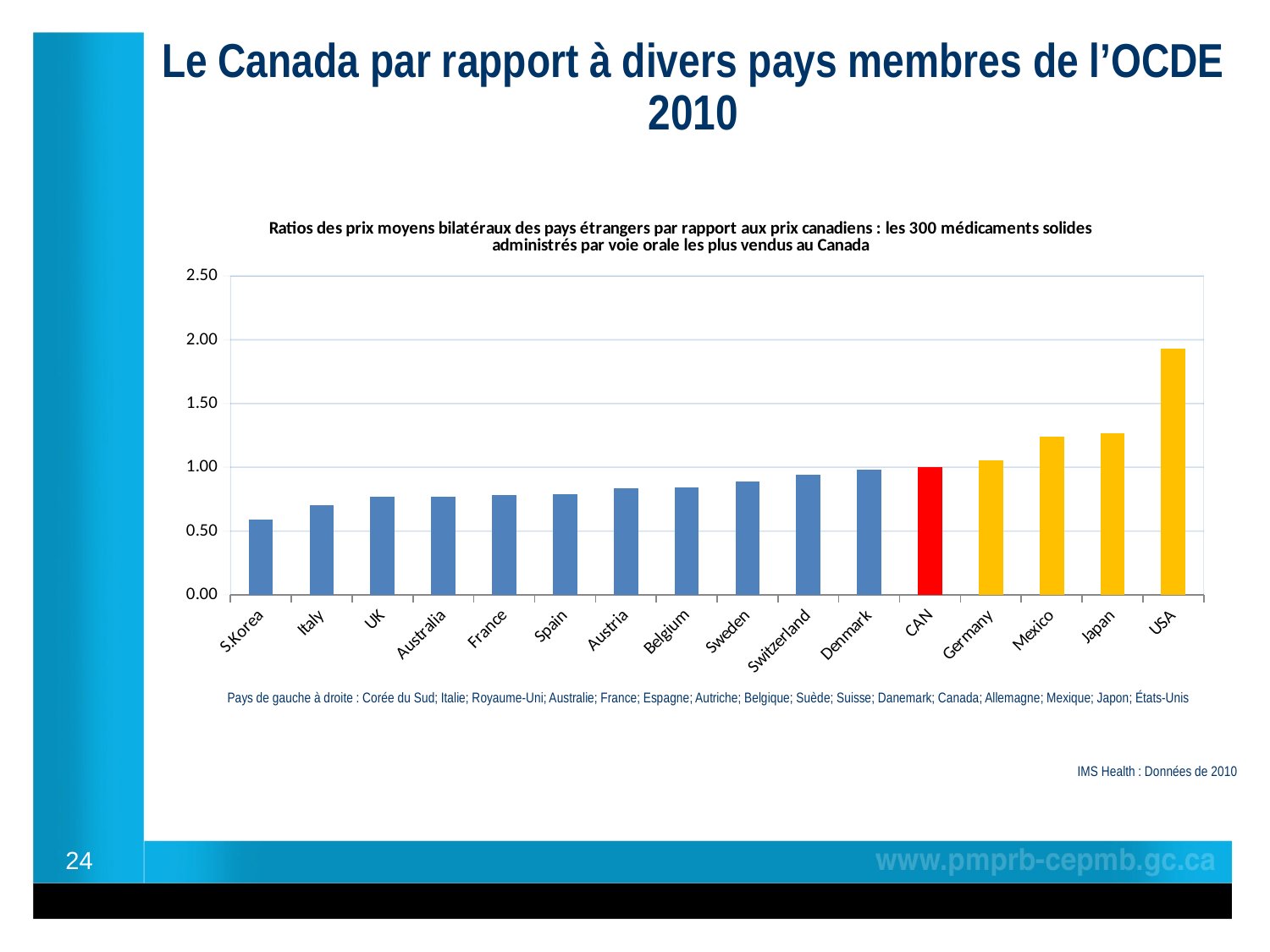
Which country has the lowest price ratio in the chart? S.Korea Which country has the highest price ratio in the chart? USA Which has the larger value, USA or Japan? USA What is the price ratio for CAN? 1.00 Is the value for USA greater or less than 1.50? greater Do the values generally rise or fall from left to right along the x axis? rise What kind of chart is shown on the slide? bar chart Is the value for Mexico greater or less than 1.00? greater Which country's bar is coloured red in the chart? CAN Is the value for S.Korea greater or less than 0.50? greater How many countries are plotted in the chart? 16